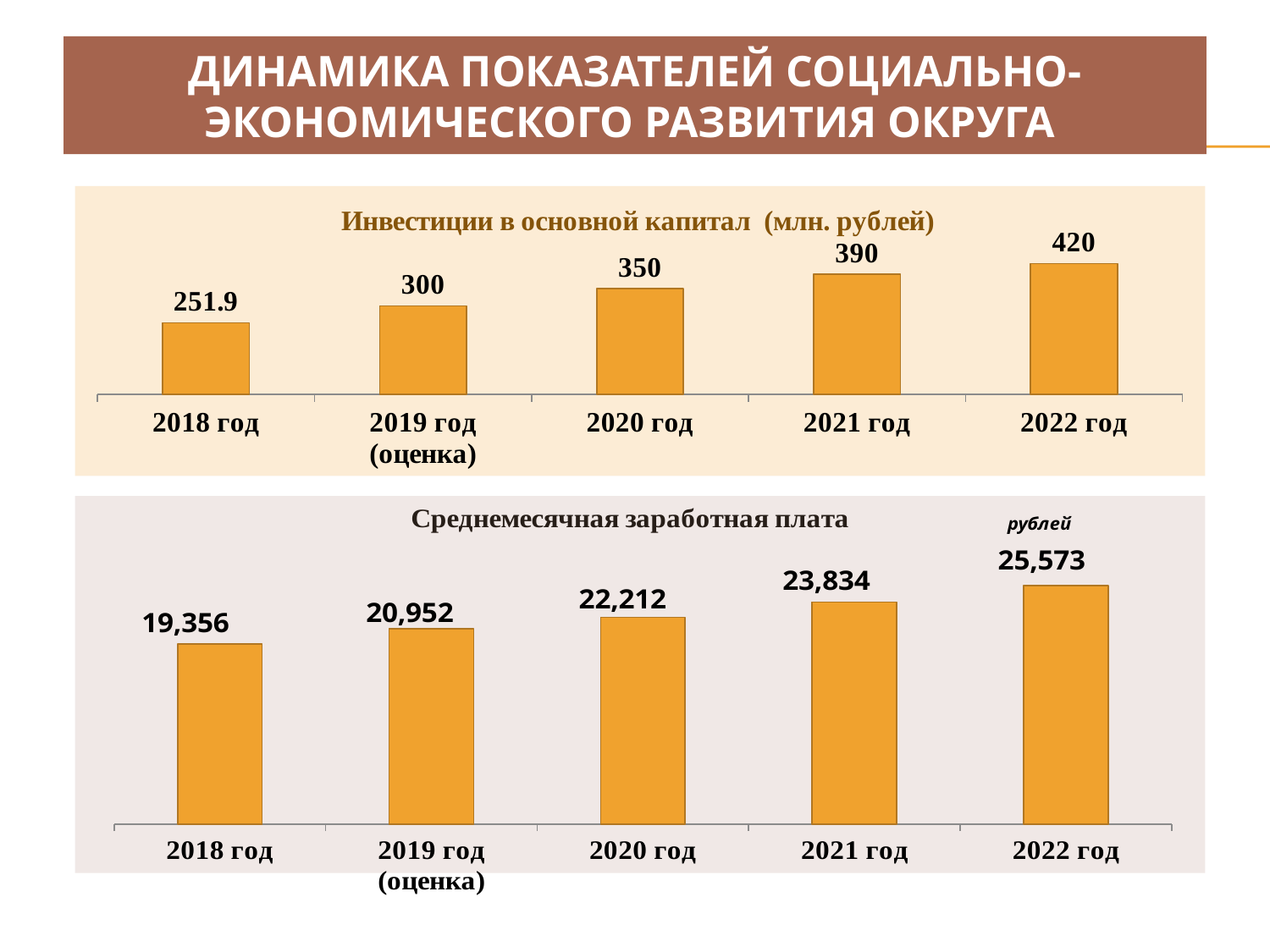
In the chart 'Инвестиции в основной капитал (млн. рублей)', what is the value for 2018 год? 251.9 In the chart 'Среднемесячная заработная плата', which year has the lowest value? 2018 год In the chart 'Среднемесячная заработная плата', what is the value for 2019 год (оценка)? 20,952 In the chart 'Среднемесячная заработная плата', what is the difference between the values for 2022 год and 2018 год? 6,217 In the chart 'Среднемесячная заработная плата', which is larger, the value for 2020 год or the value for 2022 год? 2022 год In the chart 'Инвестиции в основной капитал (млн. рублей)', what is the value for 2020 год? 350 In the chart 'Инвестиции в основной капитал (млн. рублей)', which year has the highest value? 2022 год What kind of chart is the bottom chart 'Среднемесячная заработная плата'? bar chart In the chart 'Среднемесячная заработная плата', what is the value for 2021 год? 23,834 In the chart 'Инвестиции в основной капитал (млн. рублей)', what is the difference between the values for 2022 год and 2021 год? 30 In the chart 'Инвестиции в основной капитал (млн. рублей)', how many bars are plotted? 5 In the chart 'Инвестиции в основной капитал (млн. рублей)', do the values rise or fall from 2018 год to 2022 год? rise